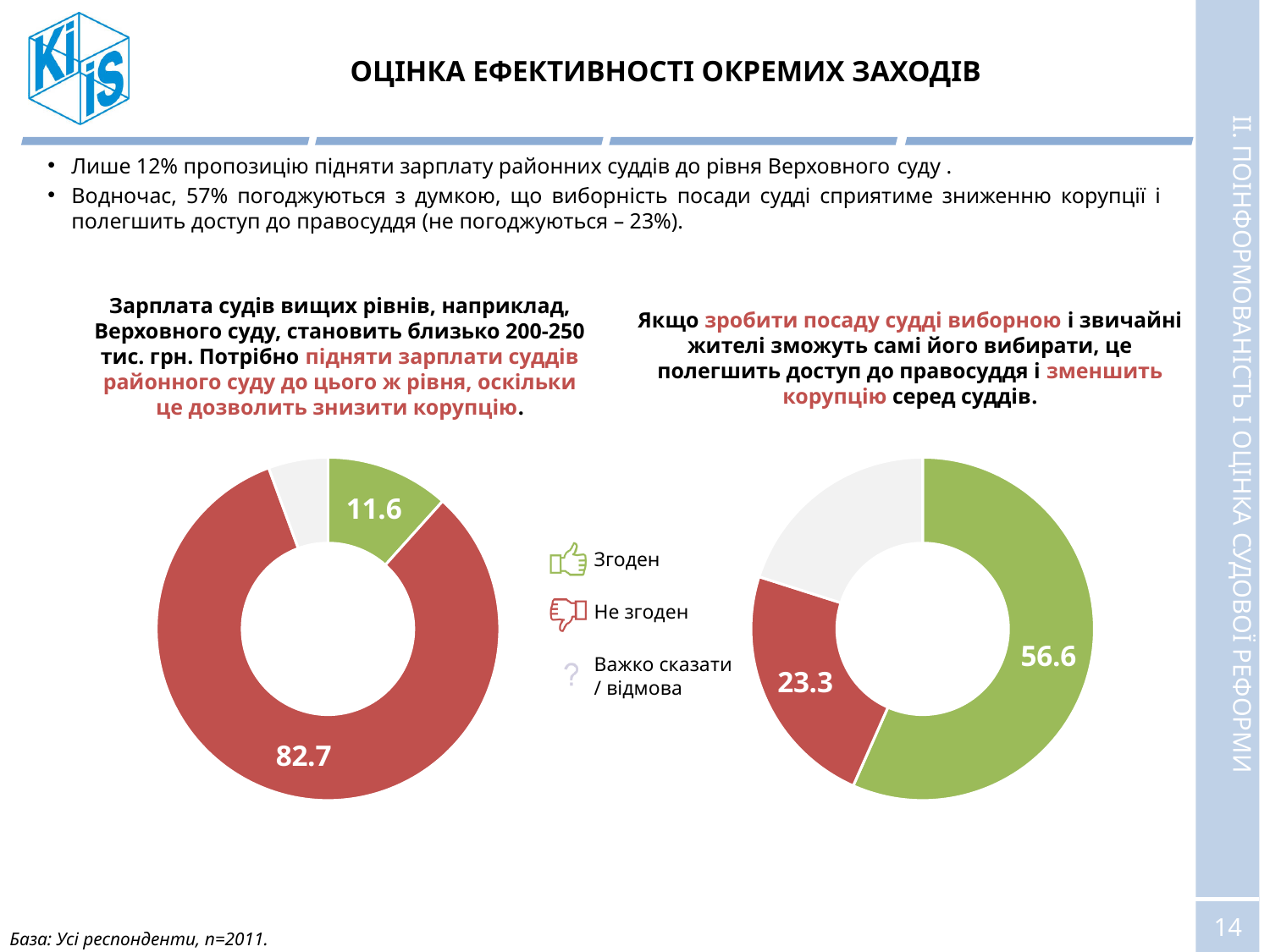
In the left donut chart, what share of respondents answered "Згоден" (green segment)? 11.6 In the right donut chart, what is the difference between the "Згоден" and "Не згоден" shares? 33.3 In the right donut chart, what share of respondents answered "Згоден" (green segment)? 56.6 Is the "Згоден" share larger in the left chart or in the right chart? Right chart In the left donut chart, what share of respondents answered "Не згоден" (red segment)? 82.7 How many response categories does the legend between the two charts list? 3 What type of chart is used on this slide? Pie (donut) chart In the right donut chart, which response has the largest share? Згоден In the left donut chart, which response has the largest share? Не згоден In the left donut chart, what is the difference between the "Не згоден" and "Згоден" shares? 71.1 In the right donut chart, what share of respondents answered "Не згоден" (red segment)? 23.3 In the right donut chart, which response has the smallest share? Важко сказати / відмова